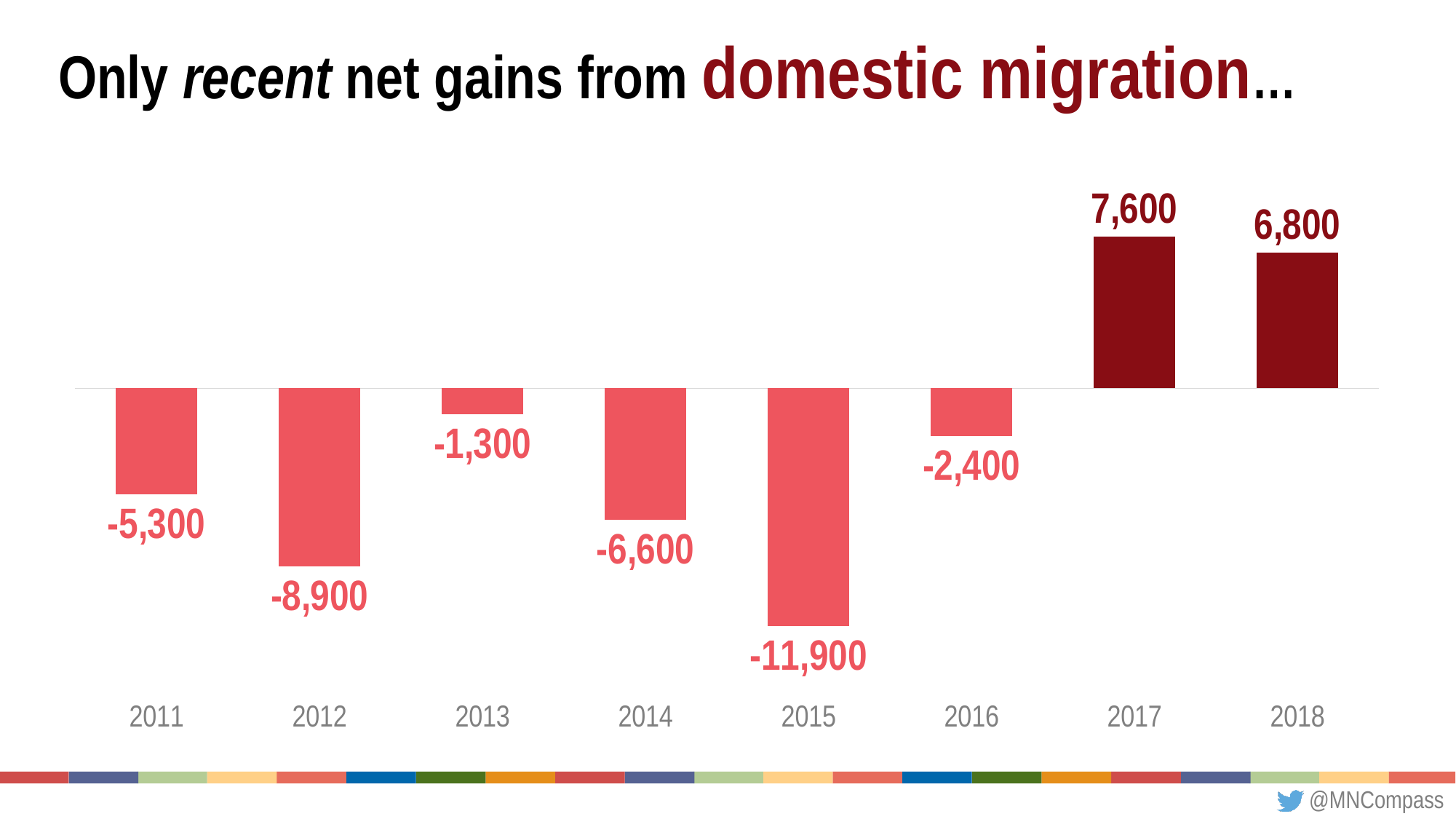
What is the value for 2013? -1,300 Which is larger, the value for 2014 or the value for 2016? 2016 How many years on the chart have positive values? 2 Which year has the lowest value? 2015 What is the title of the slide? Only recent net gains from domestic migration... What is the value for 2017? 7,600 What kind of chart is shown on the slide? bar chart What is the difference between the values for 2012 and 2011? 3,600 Which year has the highest value? 2017 What is the difference between the values for 2017 and 2018? 800 What is the value for 2015? -11,900 How many years are shown on the chart? 8